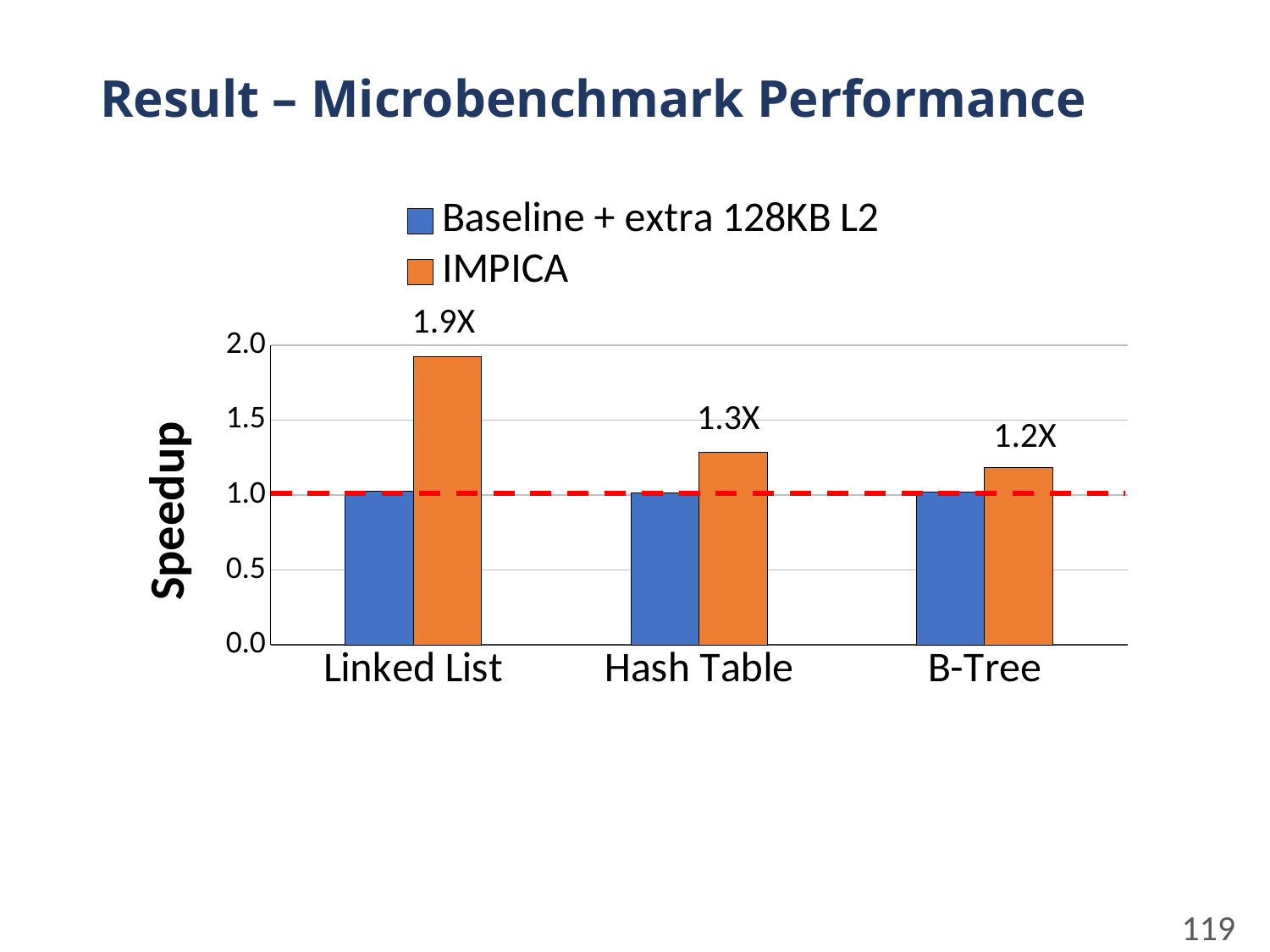
What is the IMPICA speedup for Linked List? 1.9X What kind of chart is shown on the slide? bar chart Which benchmark has the lowest IMPICA speedup? B-Tree Which benchmark has the highest IMPICA speedup? Linked List For Hash Table, which series has the larger speedup, Baseline + extra 128KB L2 or IMPICA? IMPICA How many benchmarks are shown on the x axis? 3 Do the IMPICA speedups rise or fall from Linked List to B-Tree? fall What is the IMPICA speedup for B-Tree? 1.2X How many series does the legend list? 2 Is the IMPICA speedup for Linked List greater or less than 1.5? greater What is the difference between the IMPICA speedup for Linked List and for Hash Table? 0.6X What is the IMPICA speedup for Hash Table? 1.3X